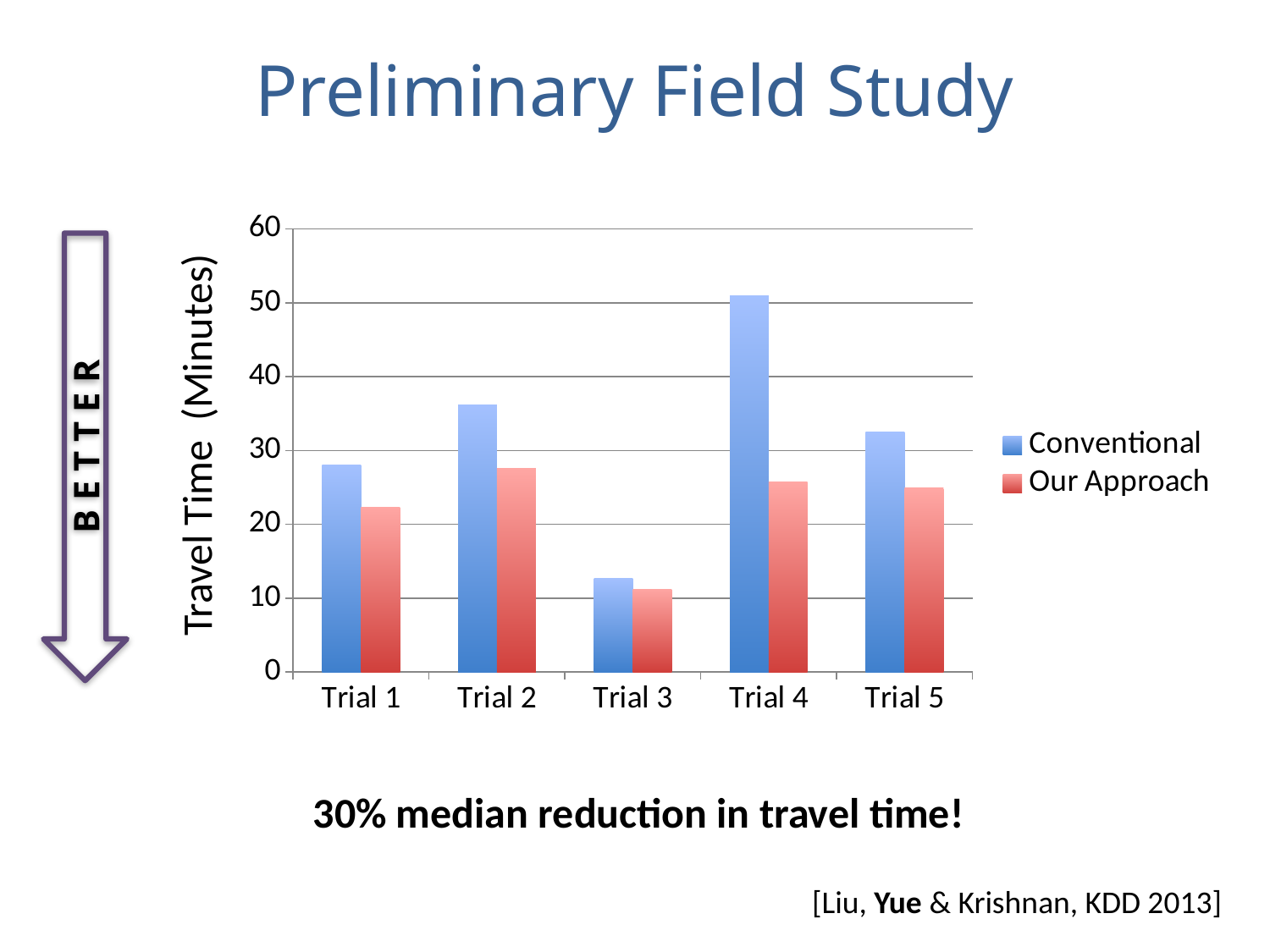
Is the Our Approach value for Trial 1 greater or less than 20? greater Is the Conventional value for Trial 4 greater or less than 40? greater Is the Conventional value for Trial 3 greater or less than 20? less Which trial has the lowest Our Approach travel time? Trial 3 Which trial has the highest Conventional travel time? Trial 4 Which trial has the lowest Conventional travel time? Trial 3 How many trials are shown on the x axis of the chart? 5 What kind of chart is shown on the slide? bar chart How many series does the chart's legend list? 2 In Trial 1, which series has the larger travel time, Conventional or Our Approach? Conventional What is the label of the chart's vertical axis? Travel Time (Minutes)